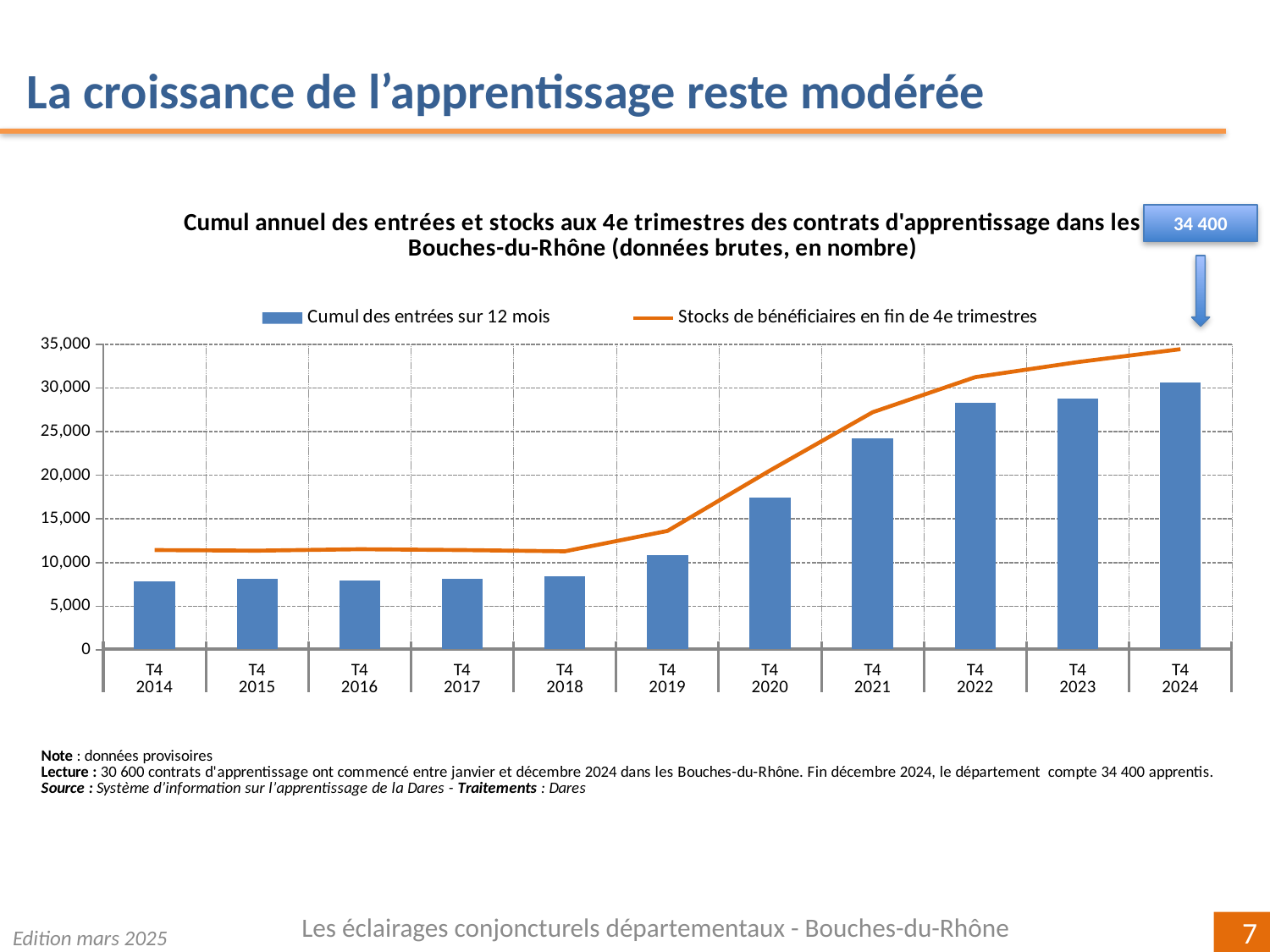
What kind of chart is shown on the slide? bar and line chart How many series does the chart legend list? 2 What colour is the line for 'Stocks de bénéficiaires en fin de 4e trimestres'? orange Is the bar for 'Cumul des entrées sur 12 mois' at T4 2014 greater or less than 10,000? less Is the 'Stocks de bénéficiaires en fin de 4e trimestres' line at T4 2018 greater or less than 15,000? less Is the bar for 'Cumul des entrées sur 12 mois' at T4 2021 greater or less than 20,000? greater What value does the callout give for the stock of beneficiaries at T4 2024? 34 400 Which is larger, the 'Cumul des entrées sur 12 mois' bar at T4 2020 or at T4 2022? T4 2022 Which quarter has the highest bar for 'Cumul des entrées sur 12 mois'? T4 2024 Which series is drawn as bars in the chart? Cumul des entrées sur 12 mois Do the 'Cumul des entrées sur 12 mois' bars generally rise or fall from T4 2018 to T4 2024? rise How many quarters (categories) are shown on the x axis? 11